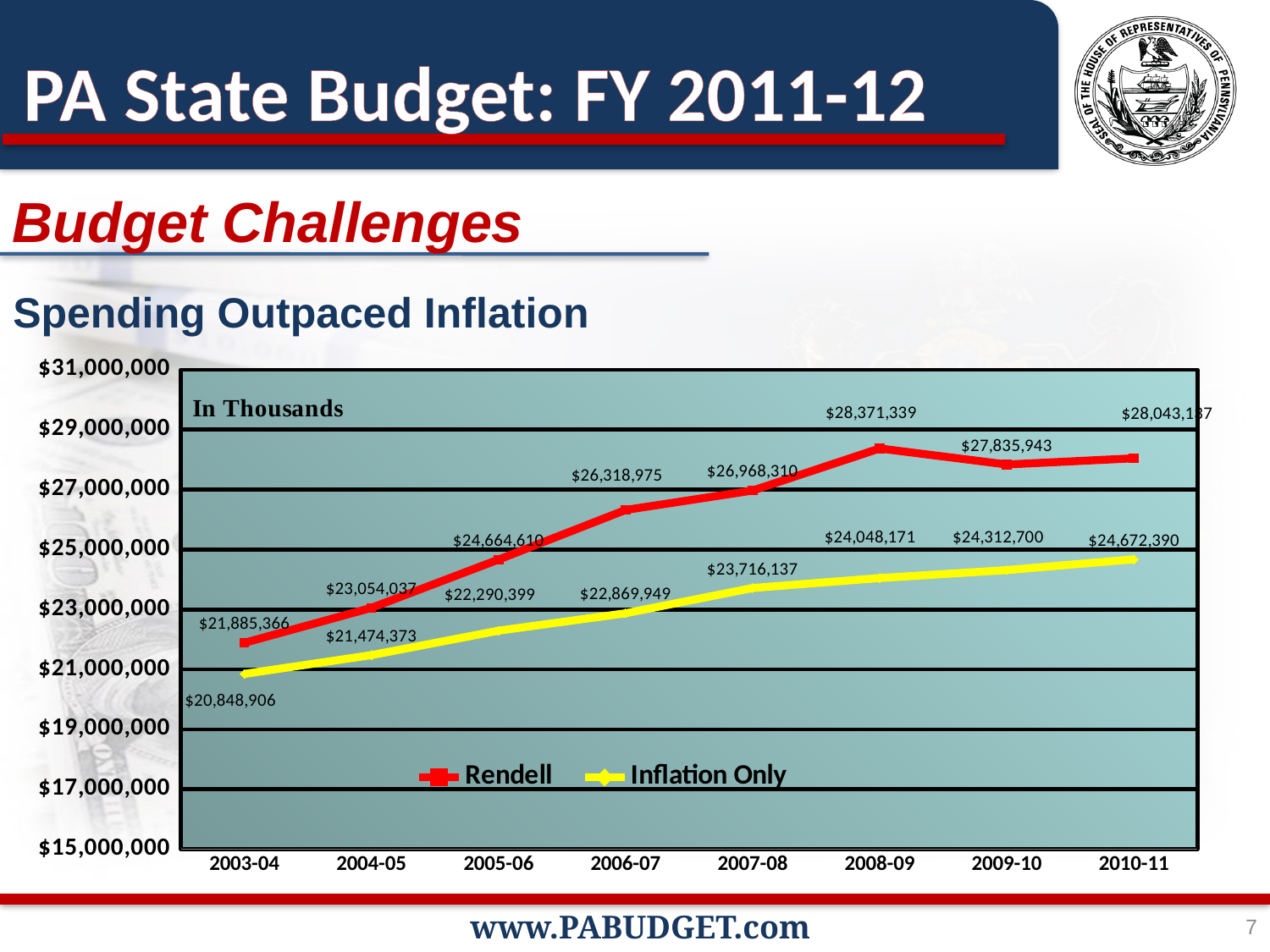
Is the Rendell value for 2009-10 greater or less than $27,000,000? greater What kind of chart is shown on the slide? Line chart How many fiscal years are shown on the x axis? 8 What is the Inflation Only value for 2003-04? $20,848,906 What is the Inflation Only value for 2010-11? $24,672,390 Which is larger in 2007-08, the Rendell value or the Inflation Only value? Rendell What is the Rendell value for 2008-09? $28,371,339 In which year does the Rendell series reach its highest value? 2008-09 How many series does the legend list? 2 What is the difference between the Rendell and Inflation Only values in 2008-09? $4,323,168 In which year is the Inflation Only series lowest? 2003-04 What is the Rendell value for 2005-06? $24,664,610